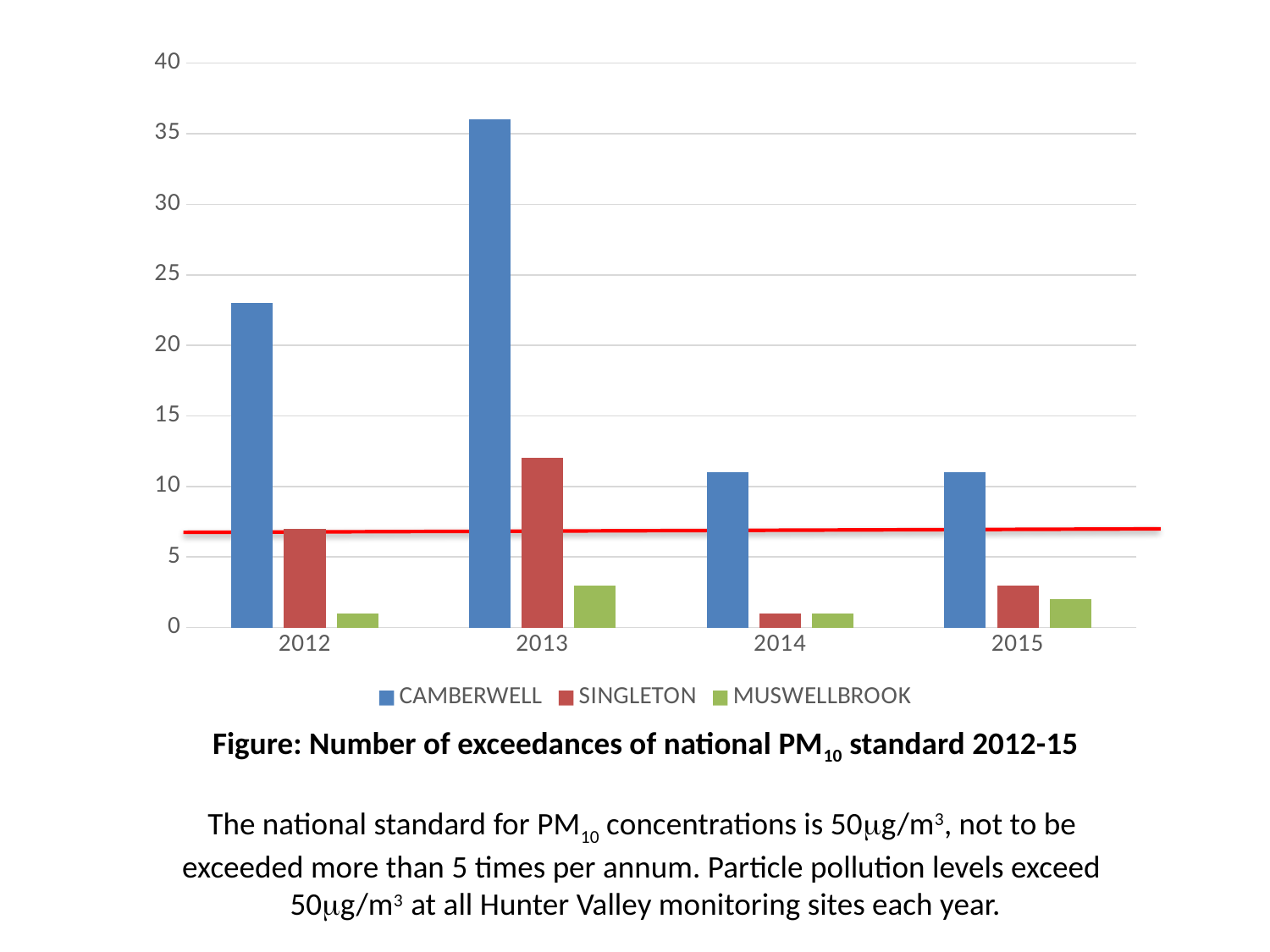
How many series does the legend list? 3 Is the CAMBERWELL value for 2012 greater or less than 20? greater In which year is the MUSWELLBROOK value highest? 2013 Is the SINGLETON value for 2012 greater or less than 10? less How many years are shown on the x axis? 4 What kind of chart is shown on the slide? bar chart Is the CAMBERWELL value for 2013 greater or less than 30? greater In which year is the SINGLETON value lowest? 2014 In which year is the CAMBERWELL value highest? 2013 Does the CAMBERWELL value rise or fall from 2013 to 2014? fall In 2013, which is larger, the CAMBERWELL value or the SINGLETON value? CAMBERWELL Which series is shown in green in the legend? MUSWELLBROOK